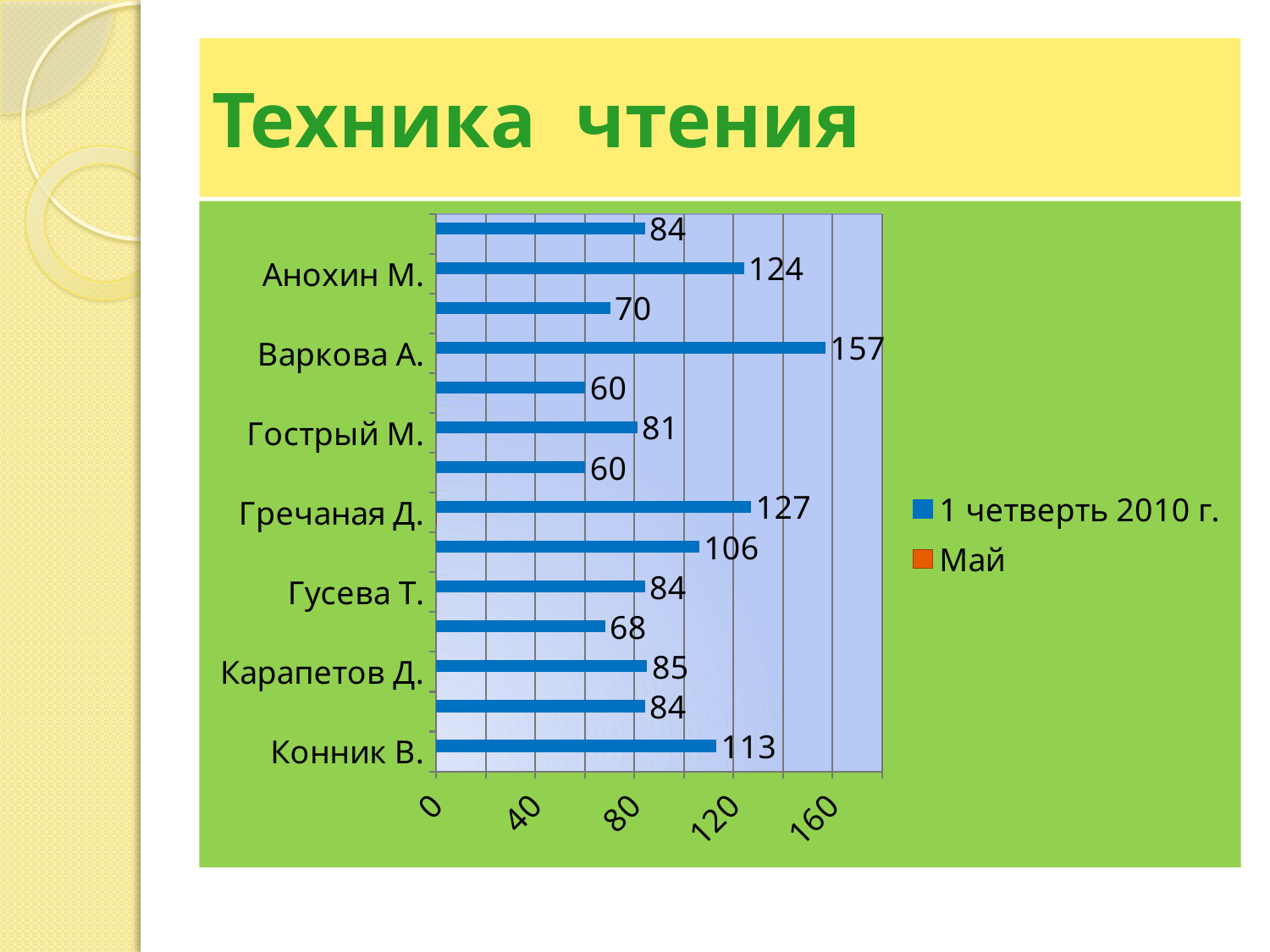
What is the difference between the values for Варкова А. and Анохин М.? 33 What is the value of the bar labelled Конник В.? 113 What type of chart is shown on the slide? bar chart Which is larger, the value for Гречаная Д. or the value for Конник В.? Гречаная Д. What is the title of the slide with the chart? Техника чтения What is the value of the bar labelled Гречаная Д.? 127 What is the highest value shown on the chart? 157 What is the value of the bar labelled Анохин М.? 124 How many series does the legend list? 2 Which labelled category has the highest value? Варкова А. What is the value of the bar labelled Варкова А.? 157 How many bars are plotted on the chart? 14